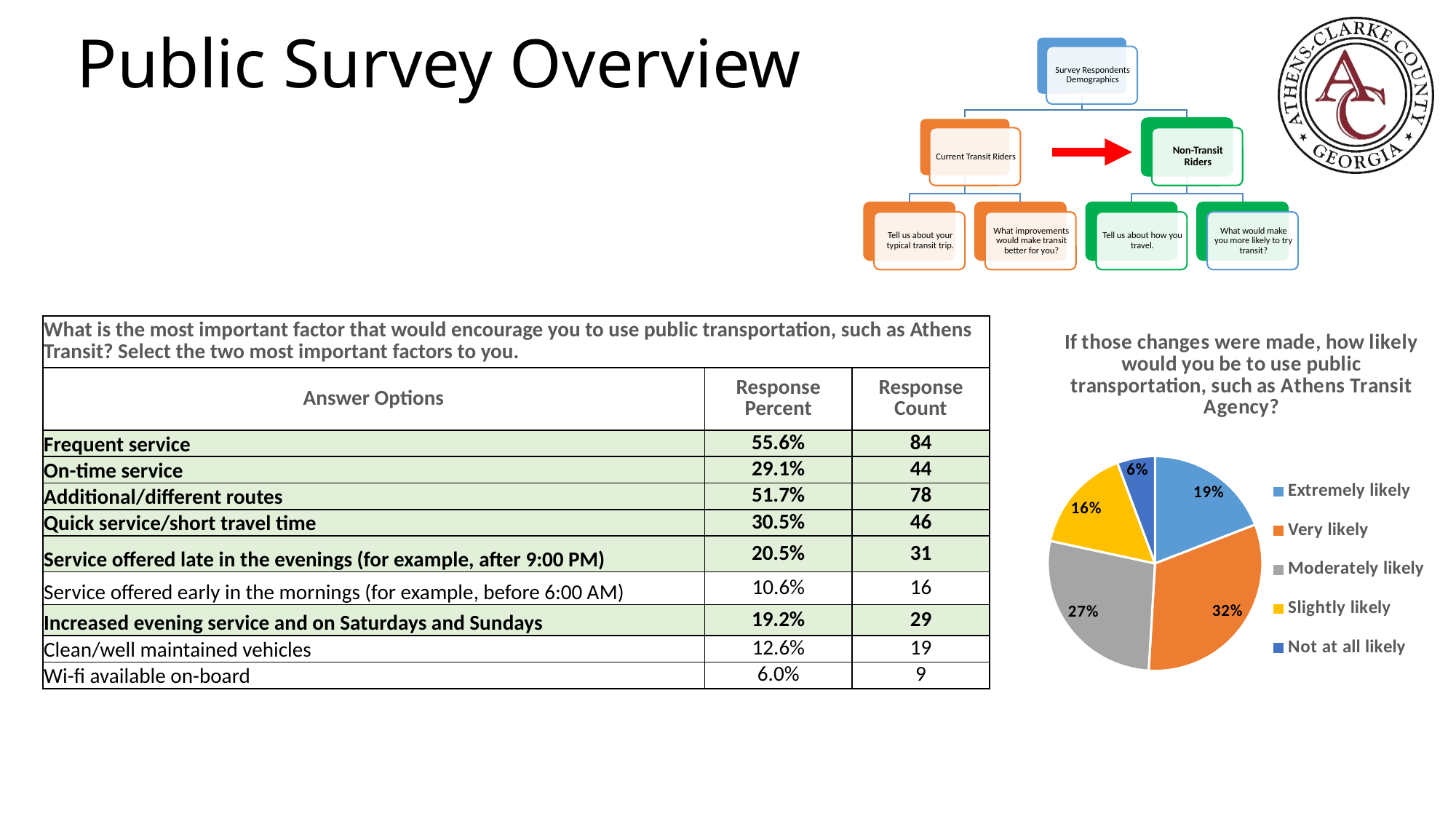
What share of the pie chart is 'Extremely likely'? 19% Which slice of the pie chart is the smallest? Not at all likely Which slice of the pie chart is the largest? Very likely What share of the pie chart is 'Not at all likely'? 6% What kind of chart is shown on the slide? pie chart In the pie chart, what colour is the 'Slightly likely' slice? yellow In the pie chart, which is larger: 'Moderately likely' or 'Extremely likely'? Moderately likely In the pie chart, what is the difference in percentage points between 'Very likely' and 'Slightly likely'? 16 How many slices does the pie chart have? 5 What share of the pie chart is 'Slightly likely'? 16% What share of the pie chart is 'Moderately likely'? 27% What share of the pie chart is 'Very likely'? 32%